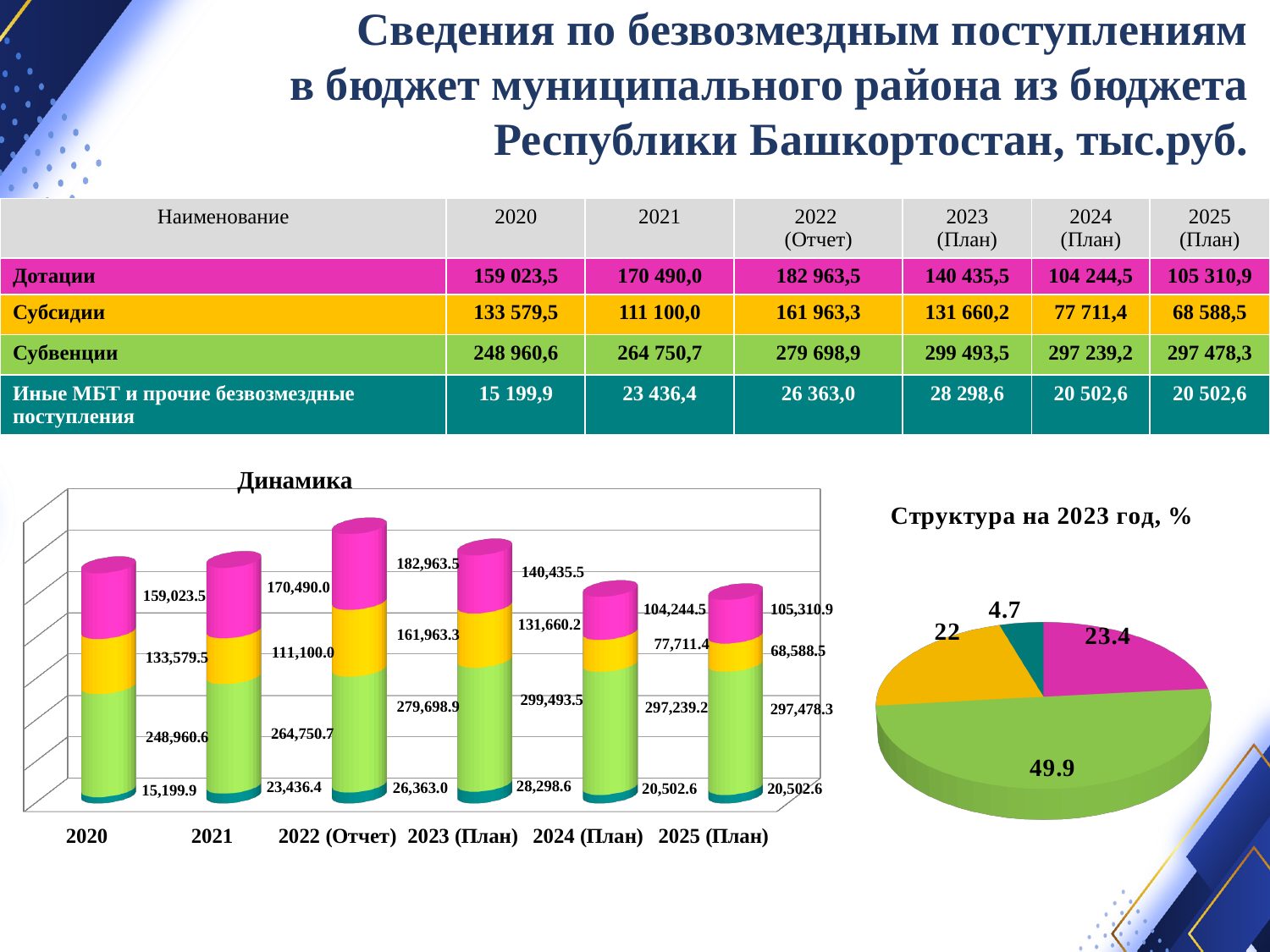
In the "Динамика" chart, what is the total of the stacked bar for 2020? 556,763.5 What kind of chart is the "Структура на 2023 год, %" chart on the right? Pie chart In the "Динамика" chart, what is the value of the green segment for 2023 (План)? 299,493.5 In the "Динамика" chart, what is the value of the bottom (teal) segment for 2021? 23,436.4 In the "Динамика" chart, which year has the tallest stacked bar? 2022 (Отчет) In the "Динамика" chart, what is the value of the pink (top) segment for 2020? 159,023.5 In the "Динамика" chart, what is the difference between the pink segment values for 2022 (Отчет) and 2023 (План)? 42,528.0 In the "Динамика" chart, what is the value of the yellow segment for 2025 (План)? 68,588.5 In the "Динамика" chart, is the yellow segment larger in 2021 or in 2022 (Отчет)? 2022 (Отчет) In the "Структура на 2023 год, %" pie chart, what is the share of the largest (green) slice? 49.9 What kind of chart is the "Динамика" chart on the left? Stacked bar chart In the "Динамика" chart, how many year categories are shown on the x axis? 6